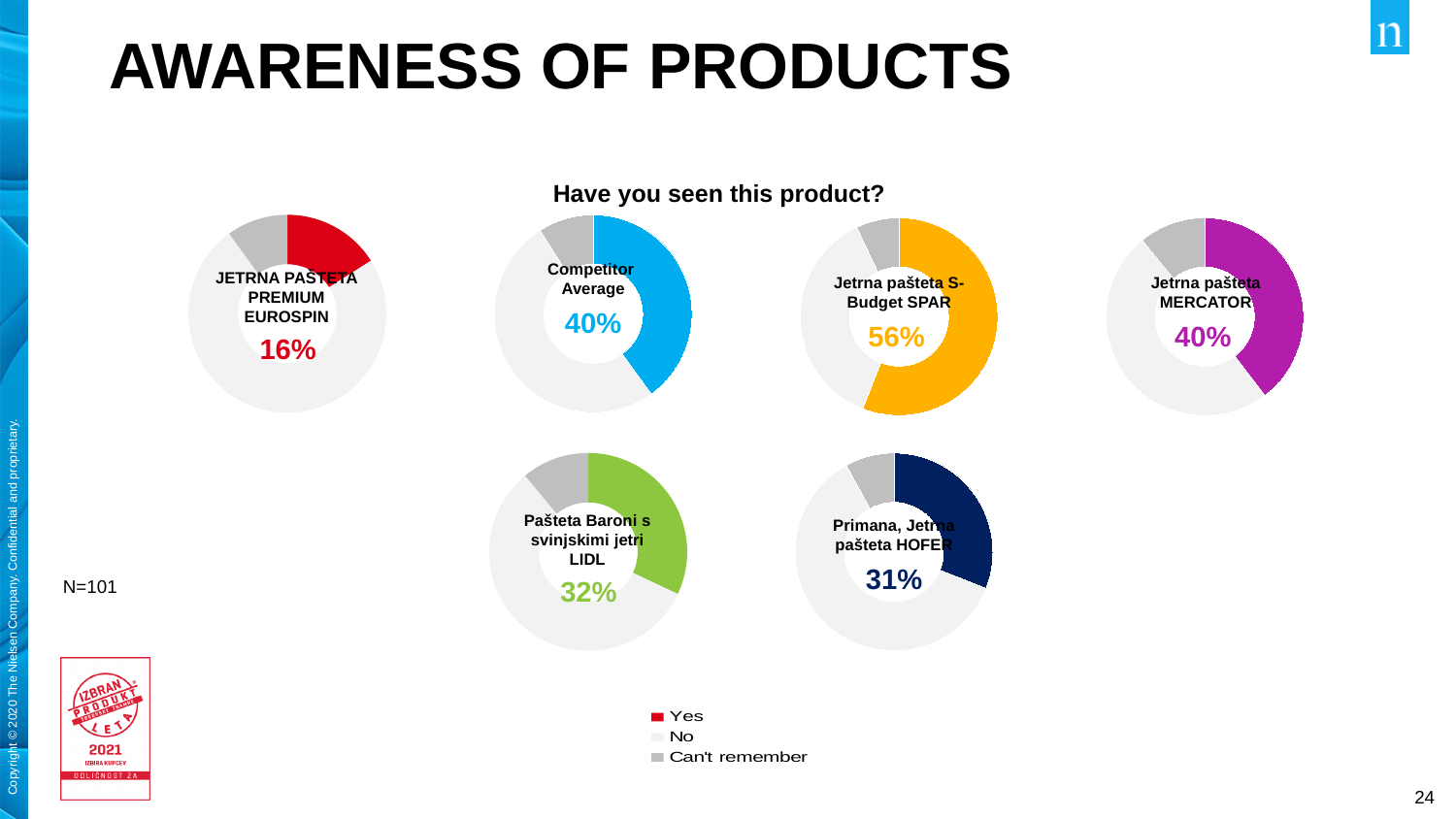
Which product has the highest awareness percentage on the slide? Jetrna pašteta S-Budget SPAR What percentage is shown for Primana, Jetrna pašteta HOFER? 31% What is the difference in percentage points between the Jetrna pašteta S-Budget SPAR value and the Jetrna pašteta MERCATOR value? 16 What is the 'Yes' share shown for Jetrna pašteta S-Budget SPAR? 56% Which product has the lowest awareness percentage on the slide? JETRNA PAŠTETA PREMIUM EUROSPIN What percentage of respondents said they had seen the JETRNA PAŠTETA PREMIUM EUROSPIN product? 16% What percentage is shown for Pašteta Baroni s svinjskimi jetri LIDL? 32% How many donut charts are shown on the slide? 6 Which has a higher awareness percentage, Jetrna pašteta MERCATOR or JETRNA PAŠTETA PREMIUM EUROSPIN? Jetrna pašteta MERCATOR How many entries does the legend list? 3 What type of chart is used to show the awareness results? Donut (pie) chart What value is shown in the Competitor Average donut chart? 40%